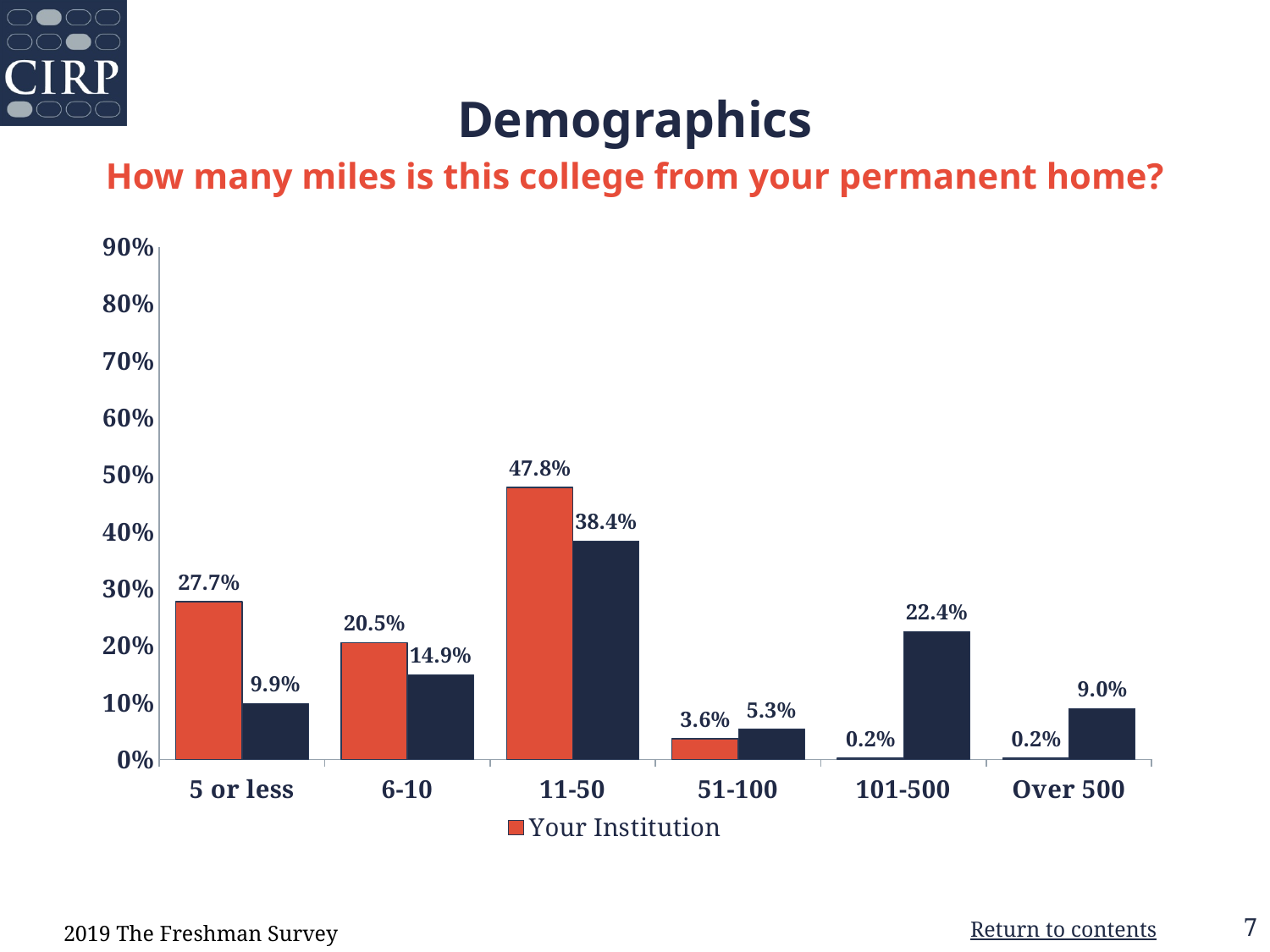
What is the value for Your Institution in the 51-100 category? 3.6% How many series does the legend list? 1 What is the value for Your Institution in the 5 or less category? 27.7% What is the difference between the Your Institution values for 6-10 and 51-100? 16.9 percentage points In the 11-50 category, is the orange bar or the dark blue bar taller? The orange bar For Your Institution, which is larger: 6-10 or 51-100? 6-10 Is the value for Your Institution in the 11-50 category greater or less than 40%? greater Which category has the highest value for Your Institution? 11-50 How many distance categories are shown on the x axis? 6 What is the difference between the Your Institution values for 11-50 and 5 or less? 20.1 percentage points What kind of chart is shown on the slide? Bar chart What is the value for Your Institution in the 11-50 category? 47.8%